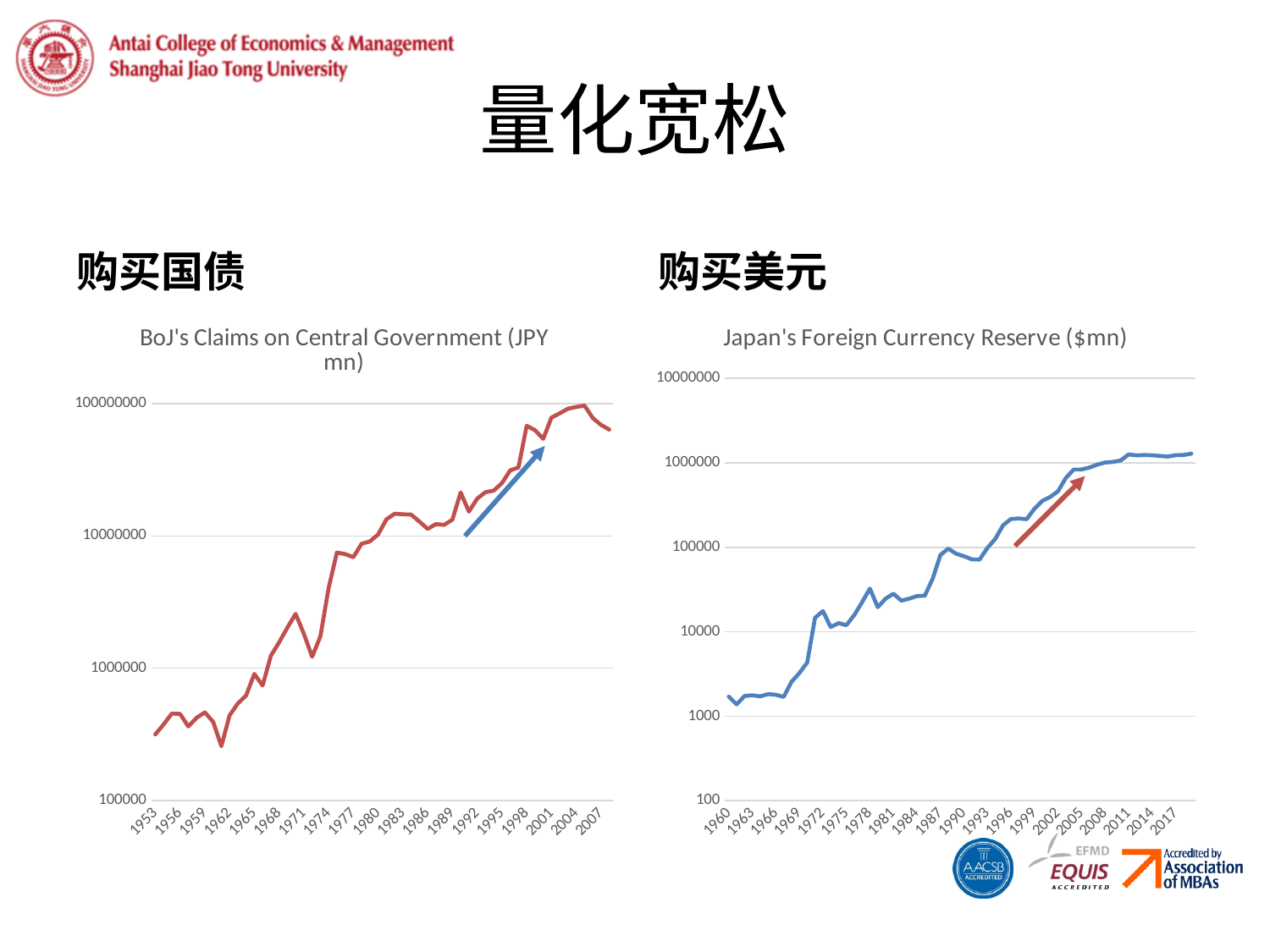
What is the title of the chart on the right side of the slide? Japan's Foreign Currency Reserve ($mn) In the left chart, 'BoJ's Claims on Central Government (JPY mn)', is the value for 1983 greater or less than 10000000? greater In the left chart, 'BoJ's Claims on Central Government (JPY mn)', is the value for 2007 greater or less than 10000000? greater In the right chart, 'Japan's Foreign Currency Reserve ($mn)', is the value for 2017 greater or less than 1000000? greater What kind of chart is the left chart, 'BoJ's Claims on Central Government (JPY mn)'? line chart In the right chart, 'Japan's Foreign Currency Reserve ($mn)', do the values generally rise or fall from 1960 to 2017? rise In the left chart, 'BoJ's Claims on Central Government (JPY mn)', do the values generally rise or fall from 1953 to 2007? rise What kind of chart is the right chart, 'Japan's Foreign Currency Reserve ($mn)'? line chart What is the first year shown on the x axis of the left chart, 'BoJ's Claims on Central Government (JPY mn)'? 1953